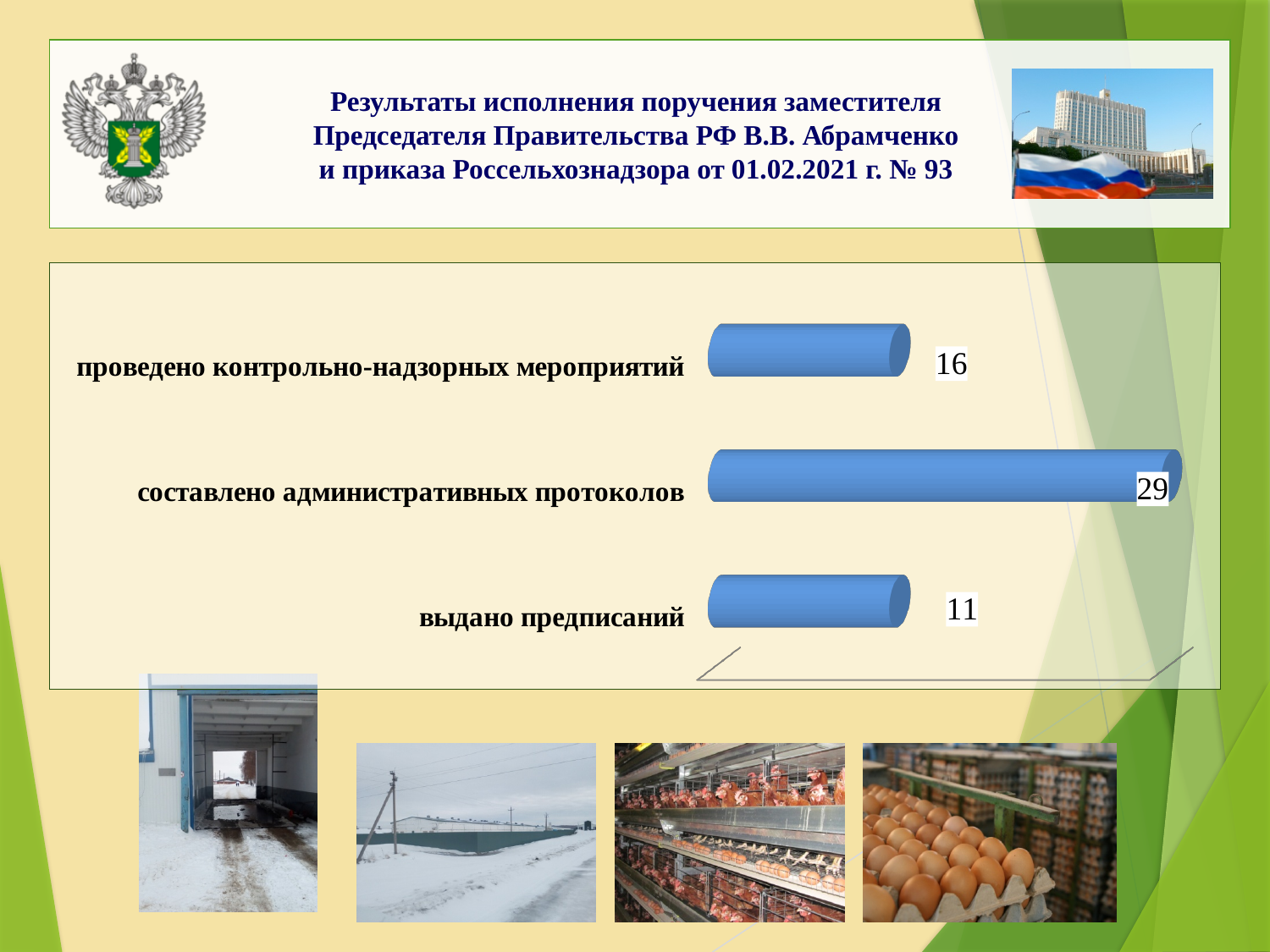
Which category has the highest value? составлено административных протоколов What is the value for 'выдано предписаний'? 11 What is the value for 'проведено контрольно-надзорных мероприятий'? 16 Which category has the lowest value? выдано предписаний How many categories does the chart show? 3 Which is larger: 'проведено контрольно-надзорных мероприятий' or 'выдано предписаний'? проведено контрольно-надзорных мероприятий What is the difference between 'составлено административных протоколов' and 'проведено контрольно-надзорных мероприятий'? 13 What is the difference between 'проведено контрольно-надзорных мероприятий' and 'выдано предписаний'? 5 What colour are the bars in the chart? blue Are the bars in the chart horizontal or vertical? horizontal What is the value for 'составлено административных протоколов'? 29 What kind of chart is shown on the slide? bar chart